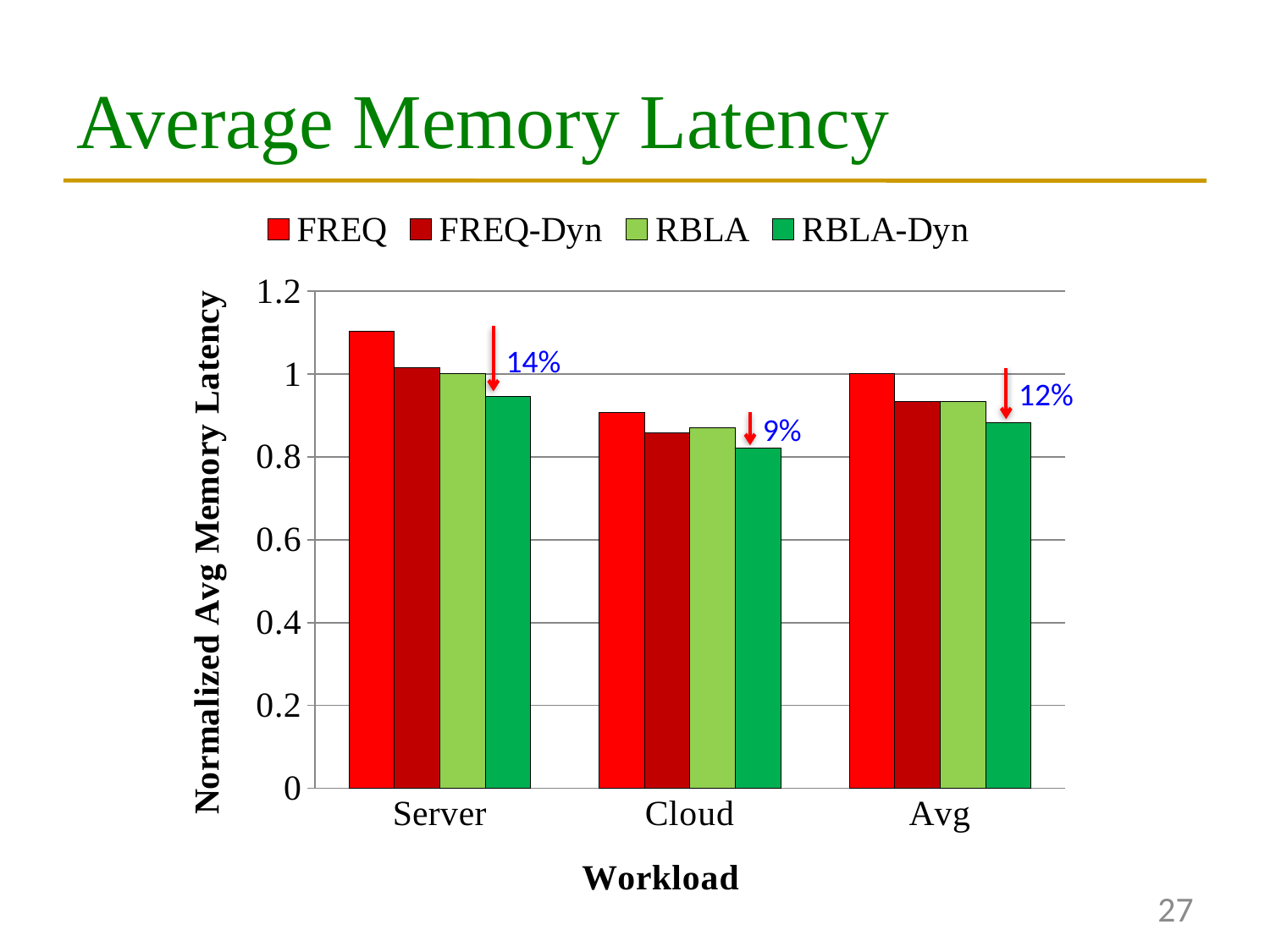
How many series does the legend list? 4 Is the RBLA-Dyn value for Cloud greater or less than 0.8? greater Which is larger: the FREQ value for Server or the FREQ value for Cloud? Server Which workload has the highest FREQ bar? Server Is the FREQ value for Cloud greater or less than 1? less What kind of chart is shown on the slide? bar chart What percentage reduction is annotated above the RBLA-Dyn bar for the Server workload? 14% Is the RBLA-Dyn value for Server greater or less than 1? less What is the title of the y axis? Normalized Avg Memory Latency How many workload categories are shown on the x axis? 3 For the Cloud workload, which series has the lowest bar? RBLA-Dyn